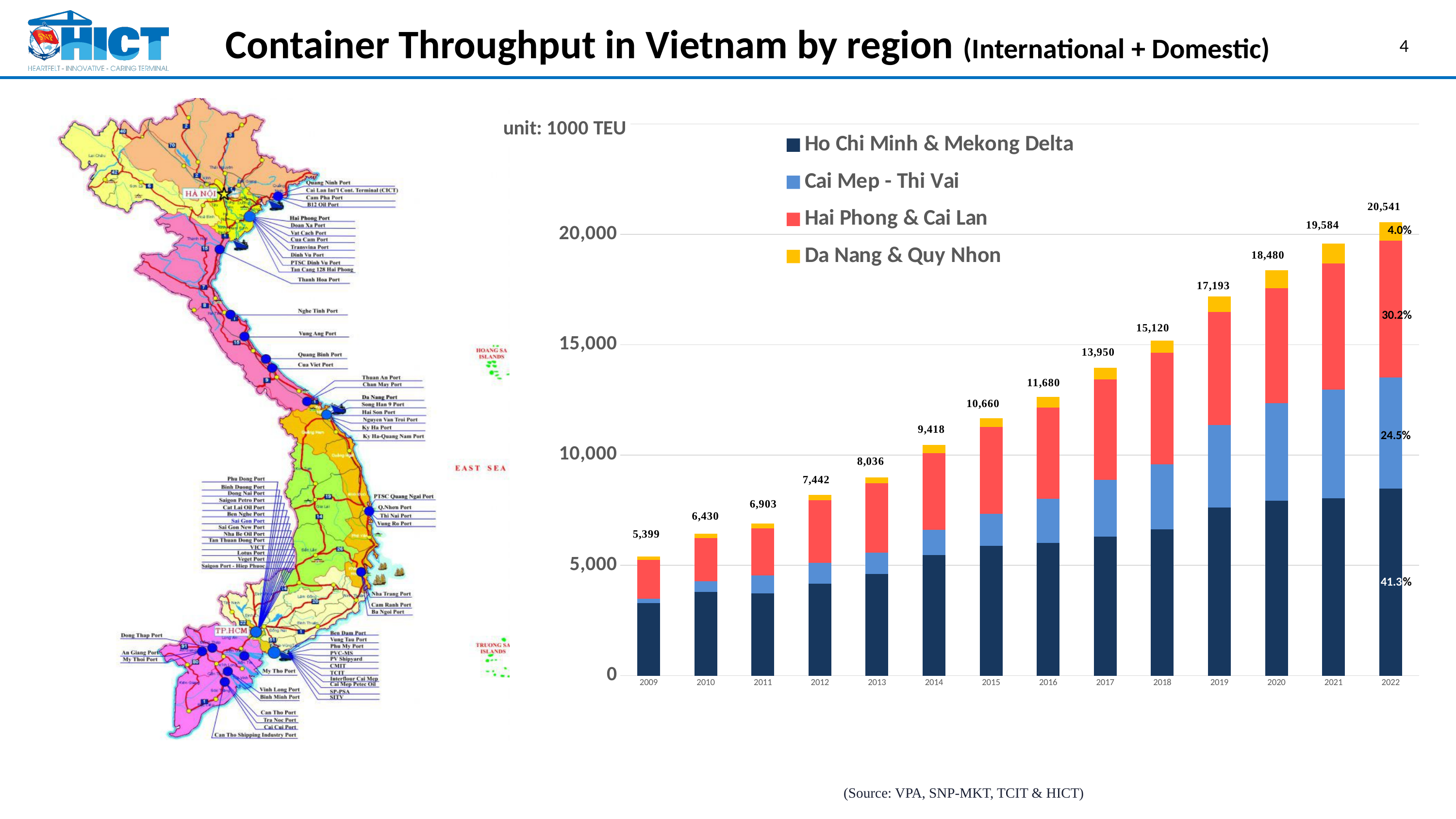
What is the total container throughput shown for 2009? 5,399 Which year has a larger total throughput, 2015 or 2016? 2016 How many series does the legend list? 4 What is the difference between the total throughput in 2022 and in 2021? 957 Which year has the highest total container throughput? 2022 What is the total container throughput shown for 2017? 13,950 What share of the 2022 total does Hai Phong & Cai Lan account for, according to the label on the bar? 30.2% What kind of chart is used to show container throughput by region? Stacked bar chart How many years are shown on the x axis of the chart? 14 What is the total container throughput shown for 2022? 20,541 Which year has the lowest total container throughput? 2009 Is the value for Ho Chi Minh & Mekong Delta in 2022 greater or less than 5,000? greater